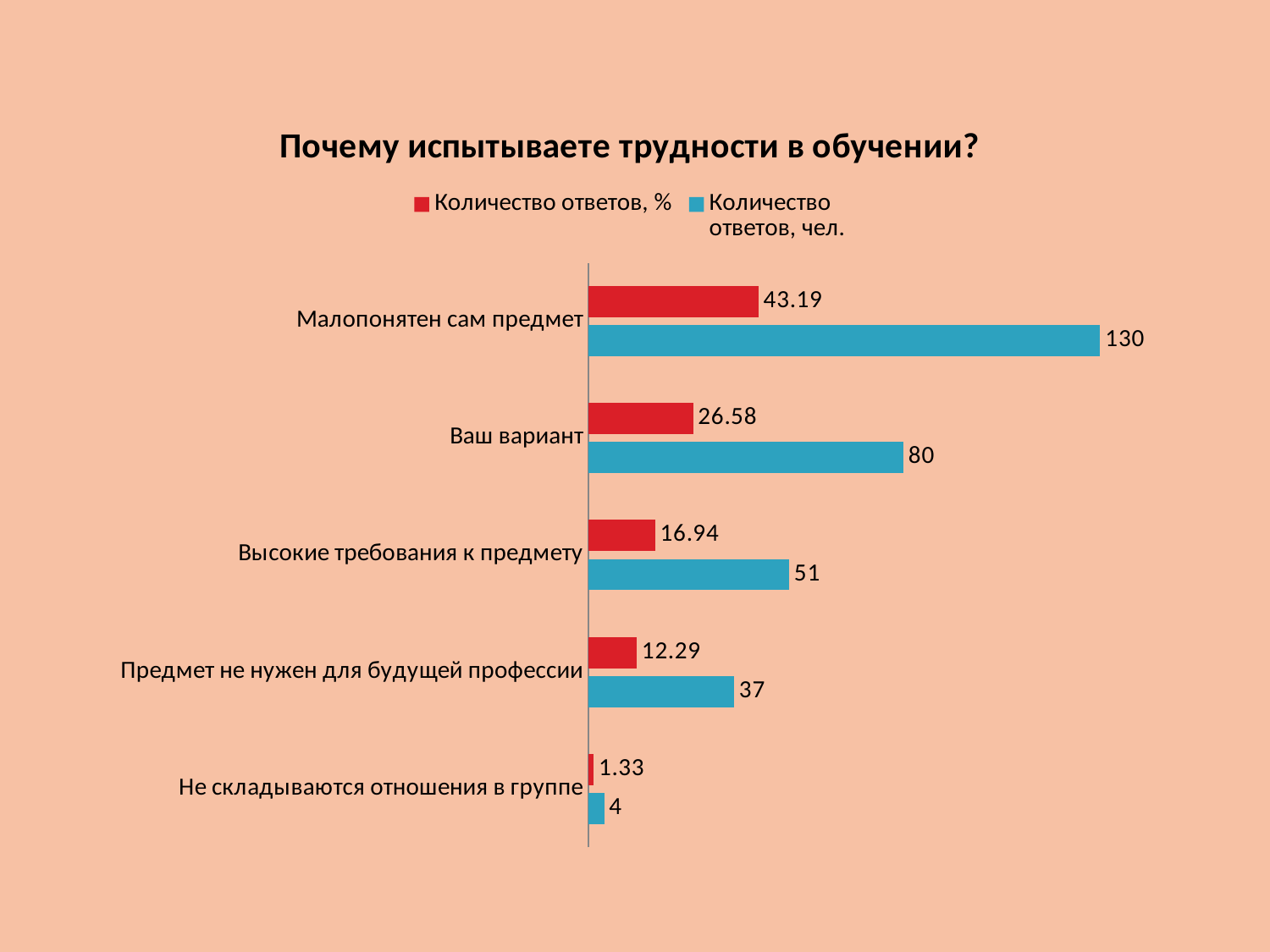
What kind of chart is shown on the slide? Bar chart How many series does the legend list? 2 What is the difference in "Количество ответов, чел." between "Малопонятен сам предмет" and "Ваш вариант"? 50 Which category has the highest value for "Количество ответов, чел."? Малопонятен сам предмет What is the value of "Количество ответов, чел." for "Малопонятен сам предмет"? 130 What is the value of "Количество ответов, %" for "Ваш вариант"? 26.58 What is the value of "Количество ответов, чел." for "Высокие требования к предмету"? 51 How many categories are shown in the chart? 5 Which category has the lowest value for "Количество ответов, %"? Не складываются отношения в группе What is the title of the chart? Почему испытываете трудности в обучении? Which is larger for "Количество ответов, чел.": "Предмет не нужен для будущей профессии" or "Высокие требования к предмету"? Высокие требования к предмету What is the value of "Количество ответов, %" for "Не складываются отношения в группе"? 1.33